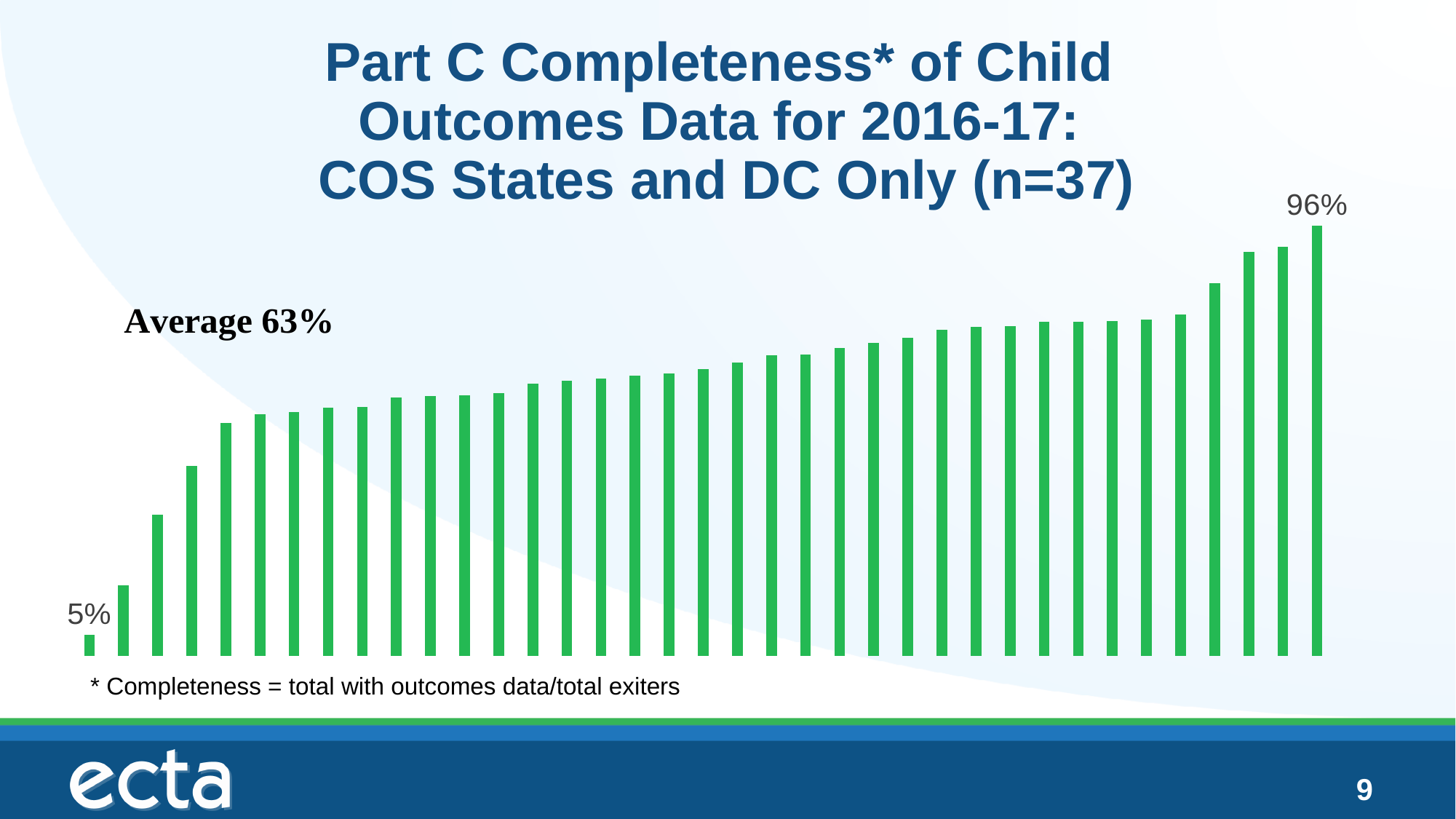
How many states and DC are included in the chart, according to the title? 37 What kind of chart is shown on the slide? Bar chart What colour are the bars in the chart? Green What is the highest completeness value shown on the chart? 96% Do the bar values rise or fall from left to right across the chart? Rise What is the lowest completeness value shown on the chart? 5% What is the difference between the highest and lowest completeness values labelled on the chart? 91 percentage points What average completeness value is stated on the slide? 63% Which bar is larger, the leftmost bar or the rightmost bar? The rightmost bar